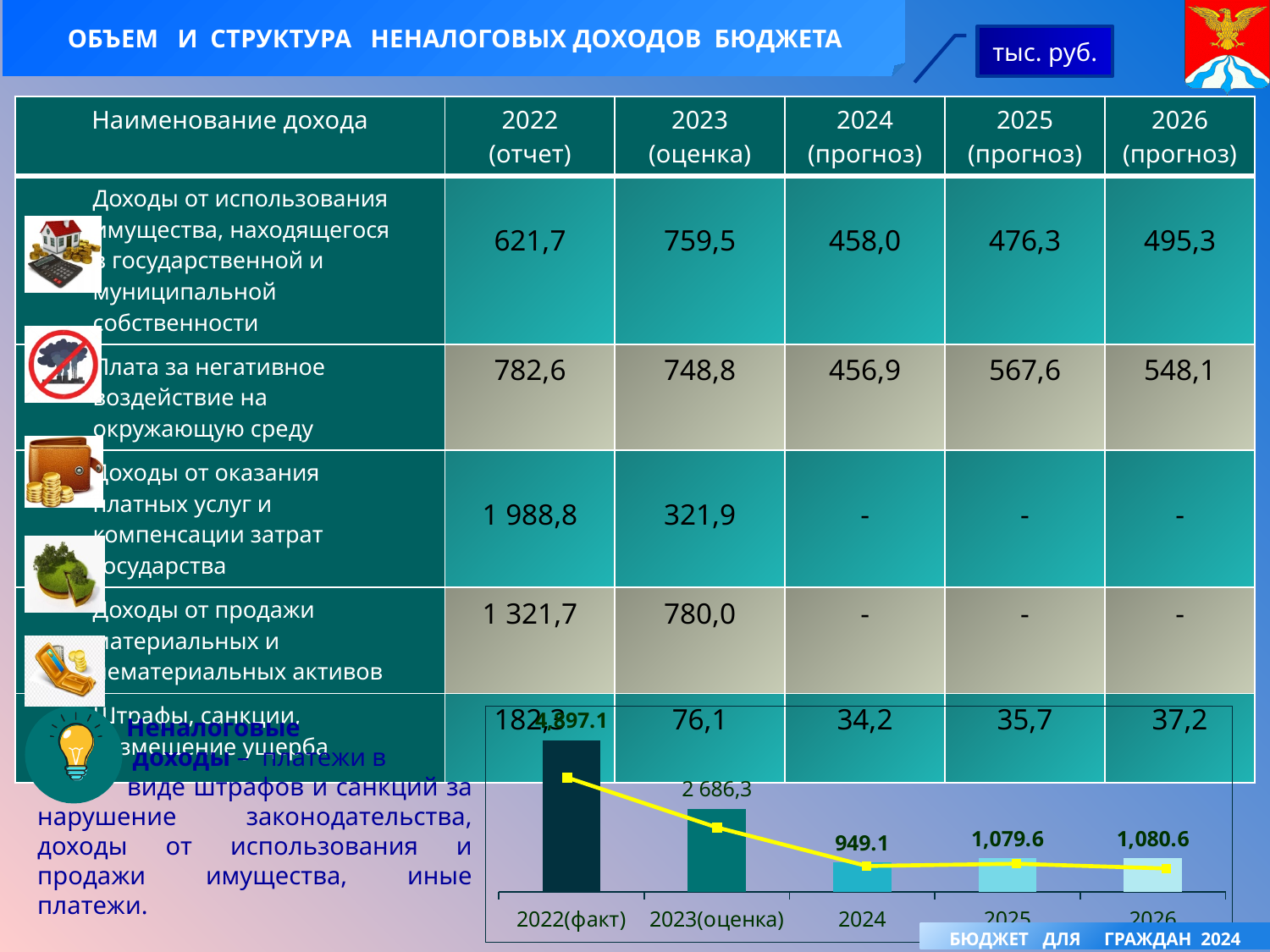
How many categories (years) are shown on the x axis of the bar chart at the bottom of the slide? 5 In the bar chart at the bottom of the slide, what is the difference between the values for 2025 and 2024? 130.5 In the bar chart at the bottom of the slide, what is the value for 2024? 949.1 In the bar chart at the bottom of the slide, what is the value for 2025? 1,079.6 What kind of chart is shown at the bottom of the slide? Bar chart with a line overlay In the bar chart at the bottom of the slide, what is the value for 2026? 1,080.6 In the bar chart at the bottom of the slide, which year has the lowest value? 2024 In the bar chart at the bottom of the slide, which year has the highest value? 2022(факт) In the bar chart at the bottom of the slide, do the values rise or fall from 2022(факт) to 2024? Fall In the bar chart at the bottom of the slide, which is larger: the value for 2023(оценка) or the value for 2024? 2023(оценка) In the bar chart at the bottom of the slide, what is the value for 2023(оценка)? 2 686,3 In the bar chart at the bottom of the slide, which is larger according to the data labels: the value for 2025 or the value for 2026? 2026